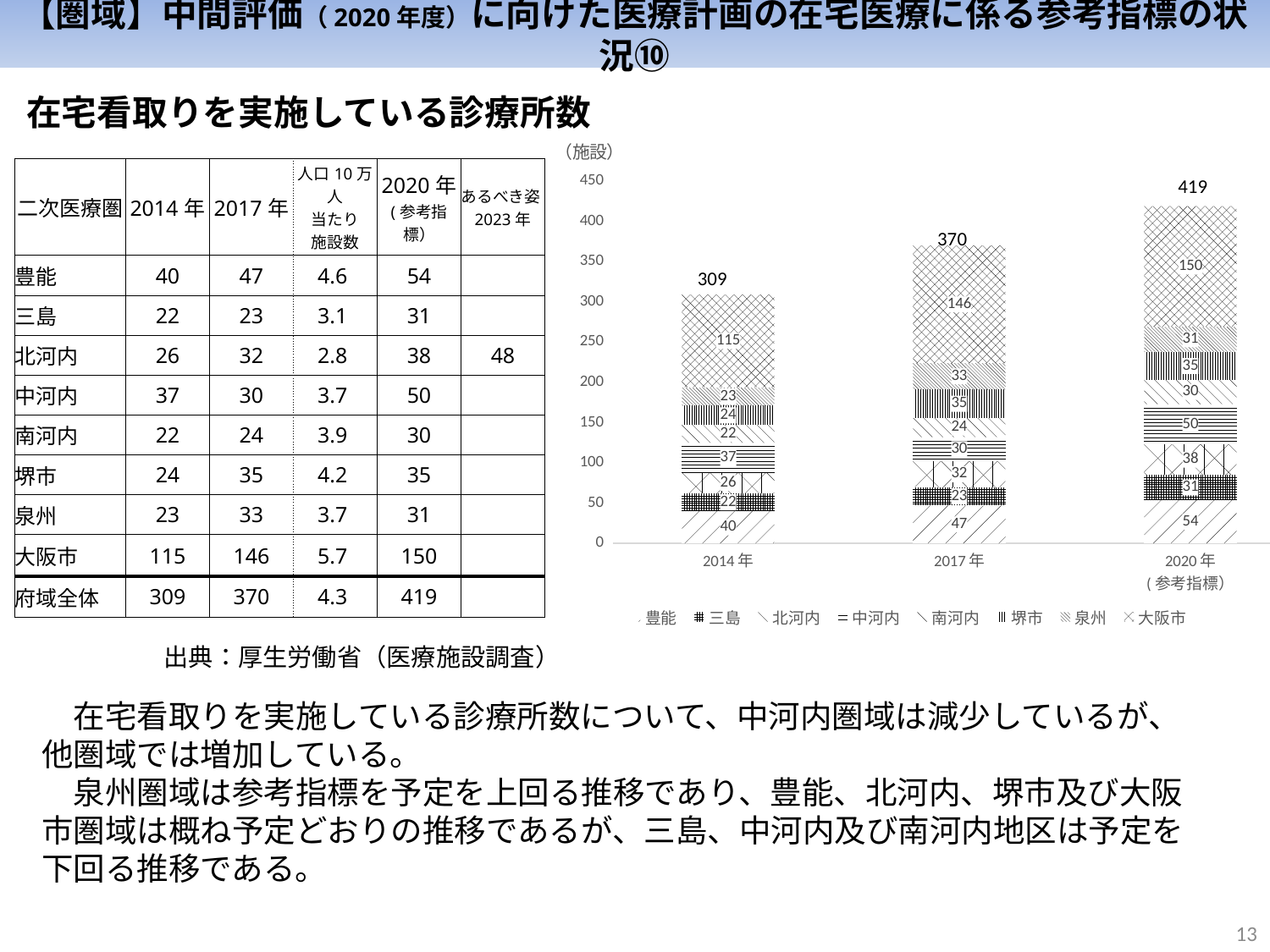
How many series does the chart legend list? 8 What is the difference between the 2020年(参考指標) total and the 2014年 total? 110 What is the value of the 豊能 segment in the 2020年(参考指標) bar? 54 What is the value of the 大阪市 segment in the 2017年 bar? 146 Which year has the highest total in the chart? 2020年(参考指標) Which year has the lowest total in the chart? 2014年 What is the total shown above the 2020年(参考指標) bar? 419 What is the total shown above the 2017年 bar? 370 What type of chart is shown on the slide? stacked bar chart What is the total shown above the 2014年 bar? 309 Do the bar totals rise or fall from 2014年 to 2020年(参考指標)? rise How many bars (years) are plotted in the chart? 3